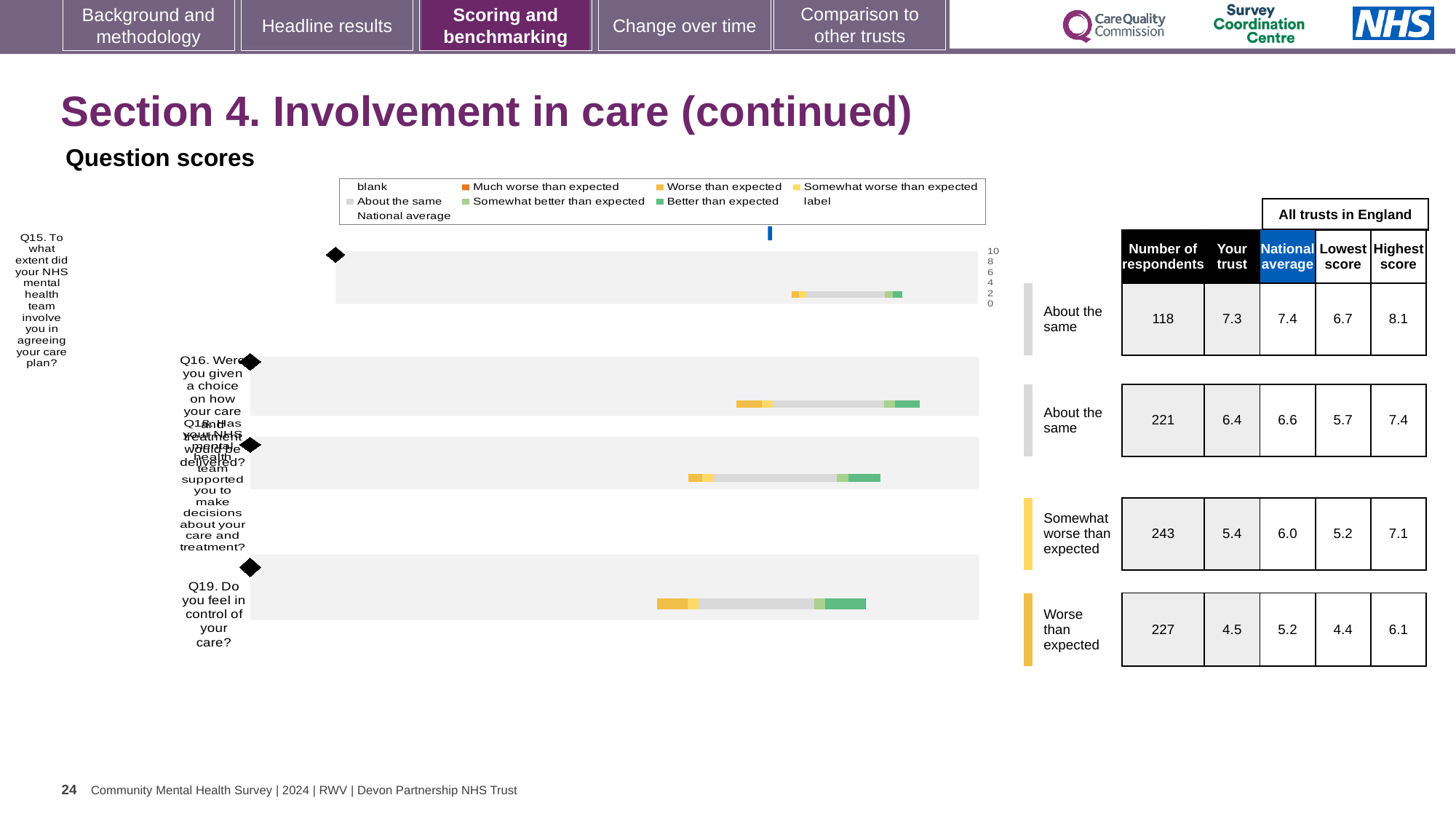
In the table next to the chart, how many respondents answered Q18 (supported to make decisions about care and treatment)? 243 Is the 'Your trust' score for Q16 larger or smaller than the national average for Q16 in the table next to the chart? smaller How many questions (bars) are plotted in the question scores chart? 4 In the table next to the chart, what is the national average for Q19 (feeling in control of your care)? 5.2 In the table next to the chart, what is the 'Your trust' score for Q15 (involving you in agreeing your care plan)? 7.3 Which question has the lowest 'Your trust' score in the table next to the chart? Q19 What kind of chart is used to show the question scores on this slide? bar chart What benchmark category is shown for Q19 next to the chart? Worse than expected What is the title shown above the question scores chart? Question scores What is the difference between the national average and the 'Your trust' score for Q18 in the table next to the chart? 0.6 Which question has the highest 'Your trust' score in the table next to the chart? Q15 In the table next to the chart, what is the highest score among all trusts in England for Q16 (given a choice on how care and treatment would be delivered)? 7.4